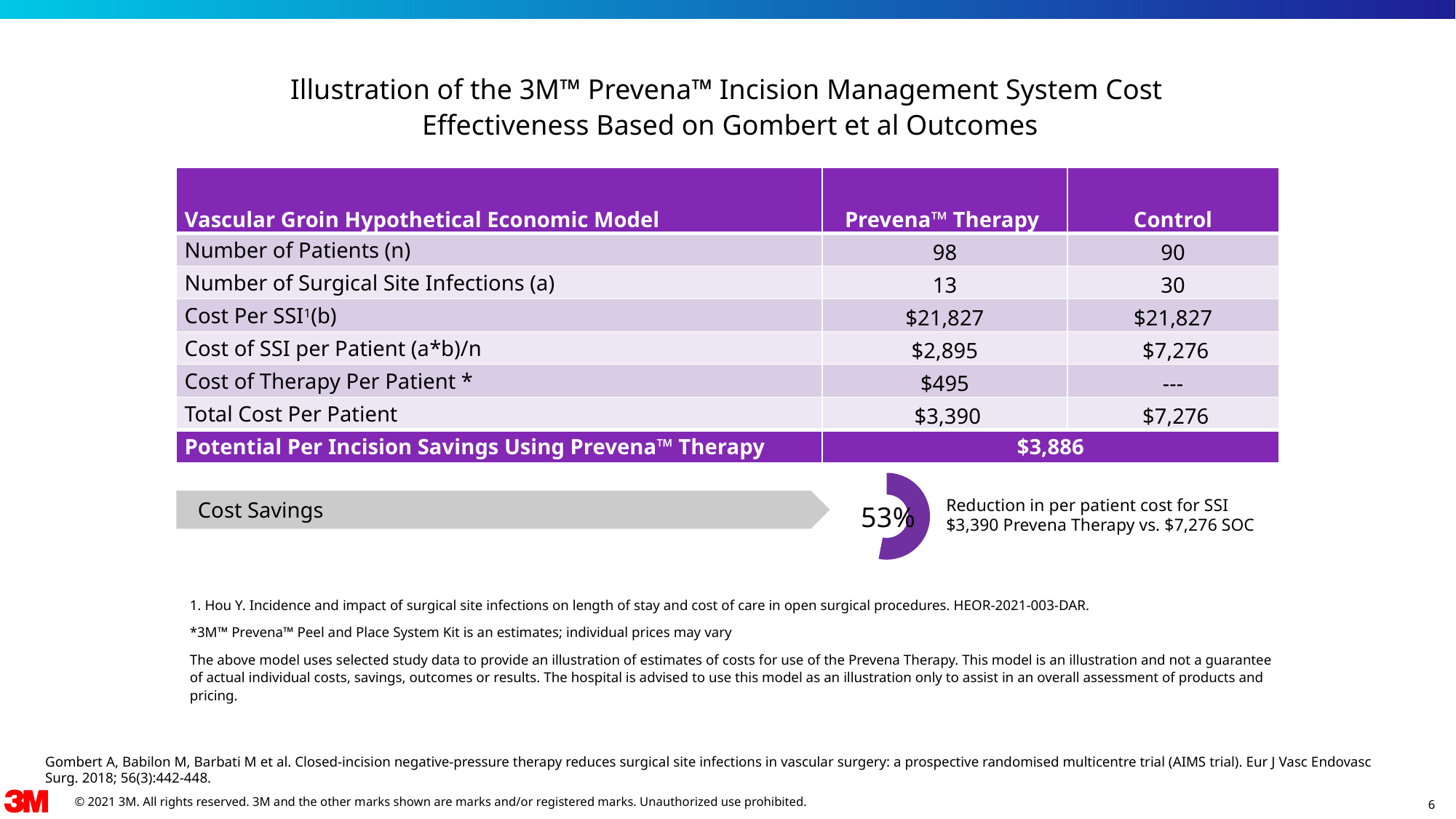
What colour is the filled portion of the 53% donut chart? Purple What two per-patient costs are compared in the text next to the 53% donut chart? $3,390 Prevena Therapy vs. $7,276 SOC Is the value shown in the donut chart greater or less than 50%? greater What kind of chart is used to display the 53% figure? Donut (pie) chart What percentage is shown in the donut chart next to the Cost Savings arrow? 53% What does the 53% in the donut chart represent, according to the text beside it? Reduction in per patient cost for SSI